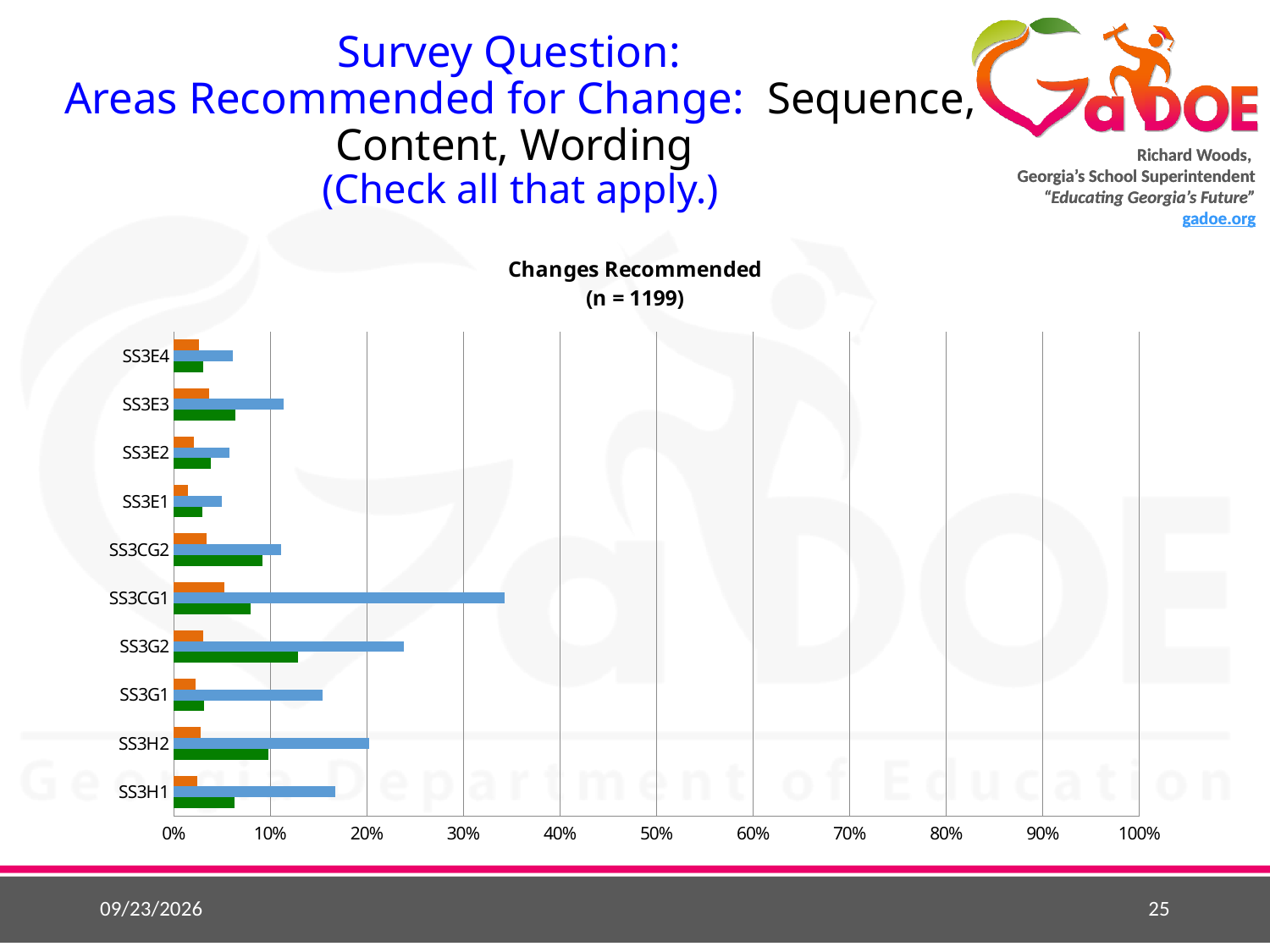
Is the blue bar for SS3H1 greater or less than 20%? less Is the blue bar for SS3G2 greater or less than 20%? greater What kind of chart is shown on the slide? bar chart Which has the longer blue bar, SS3E3 or SS3E1? SS3E3 Is the blue bar for SS3CG1 greater or less than 30%? greater Which has the longer blue bar, SS3CG1 or SS3G2? SS3CG1 What is the title of the chart? Changes Recommended (n = 1199) How many standard categories are listed on the vertical axis of the chart? 10 Which category has the longest blue bar? SS3CG1 What sample size (n) is given in the chart title? 1199